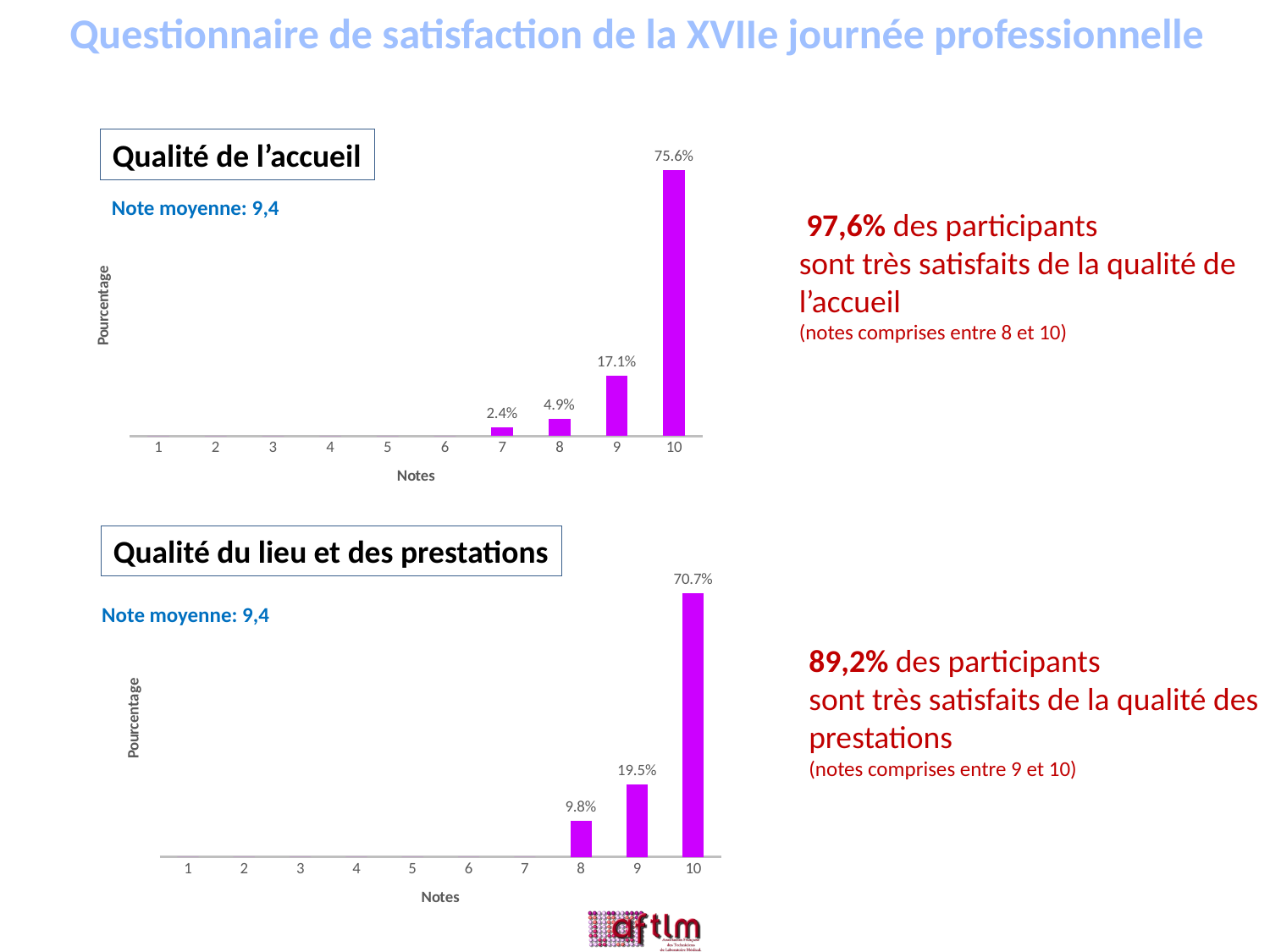
In the 'Qualité de l'accueil' chart, what percentage is shown for note 10? 75.6% In the 'Qualité du lieu et des prestations' chart, what percentage is shown for note 8? 9.8% In the 'Qualité de l'accueil' chart, what percentage is shown for note 7? 2.4% In the 'Qualité de l'accueil' chart, which is larger: the percentage for note 8 or for note 9? note 9 In the 'Qualité du lieu et des prestations' chart, which note has the highest percentage? 10 In the 'Qualité du lieu et des prestations' chart, what percentage is shown for note 10? 70.7% In the 'Qualité de l'accueil' chart, which note has the highest percentage? 10 In the 'Qualité du lieu et des prestations' chart, what is the difference between the percentages for note 9 and note 8? 9.7% What kind of chart is the 'Qualité de l'accueil' chart? bar chart How many notes are listed along the x axis of the 'Qualité du lieu et des prestations' chart? 10 In the 'Qualité de l'accueil' chart, what is the difference between the percentages for note 10 and note 9? 58.5% In the 'Qualité de l'accueil' chart, what percentage is shown for note 9? 17.1%